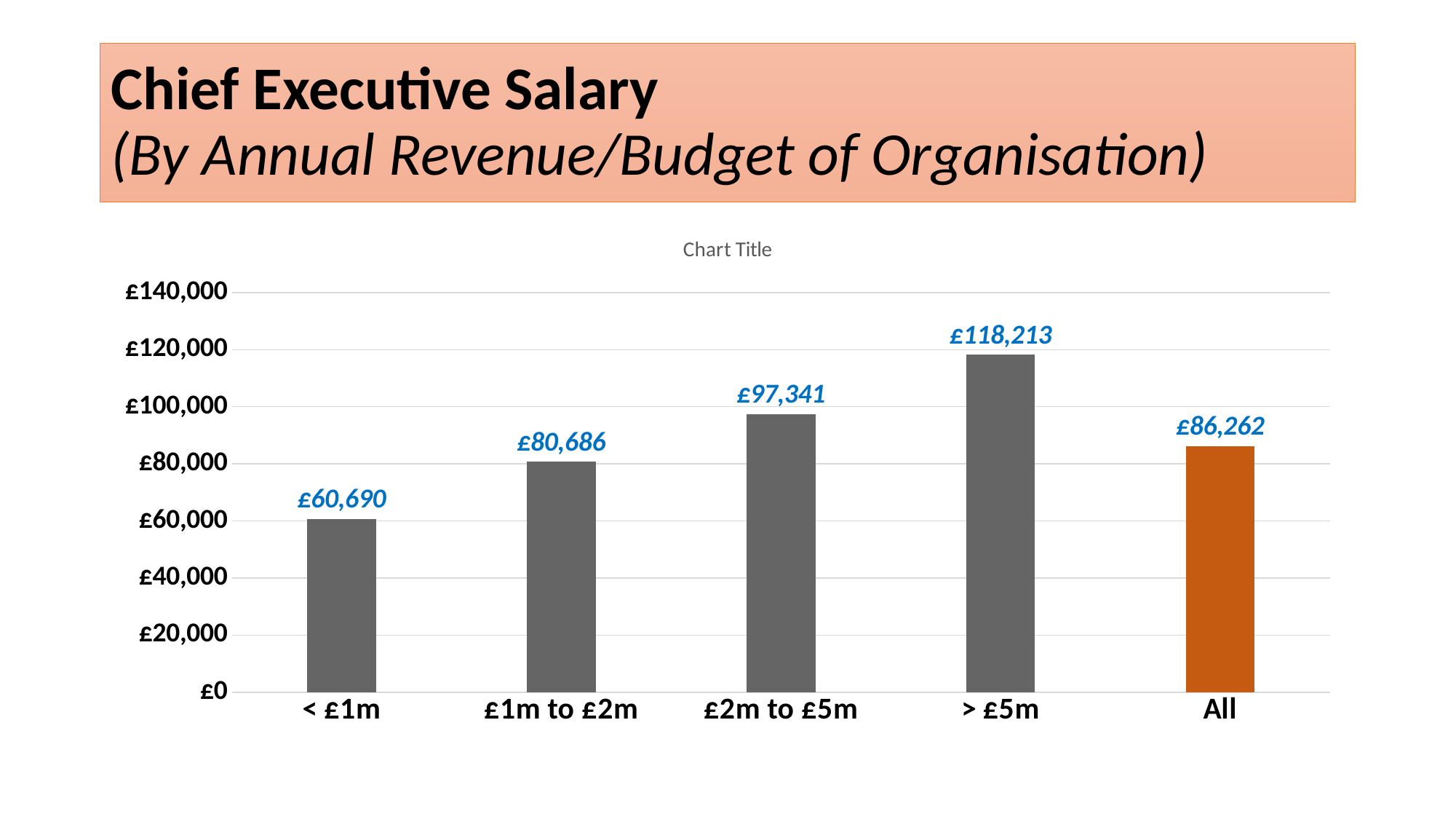
Which category has the lowest chief executive salary? < £1m What is the chief executive salary for organisations with annual revenue of < £1m? £60,690 What is the chief executive salary for organisations with annual revenue of > £5m? £118,213 What is the chief executive salary for organisations with annual revenue of £2m to £5m? £97,341 What is the chief executive salary shown for the 'All' category? £86,262 What is the difference between the chief executive salary for > £5m organisations and < £1m organisations? £57,523 What is the chief executive salary for organisations with annual revenue of £1m to £2m? £80,686 Which bar on the chart is coloured orange rather than grey? All Which is larger: the chief executive salary for £2m to £5m organisations or the 'All' figure? £2m to £5m What kind of chart is shown on the slide? Bar chart How many categories are shown on the x axis of the chart? 5 Which category has the highest chief executive salary? > £5m